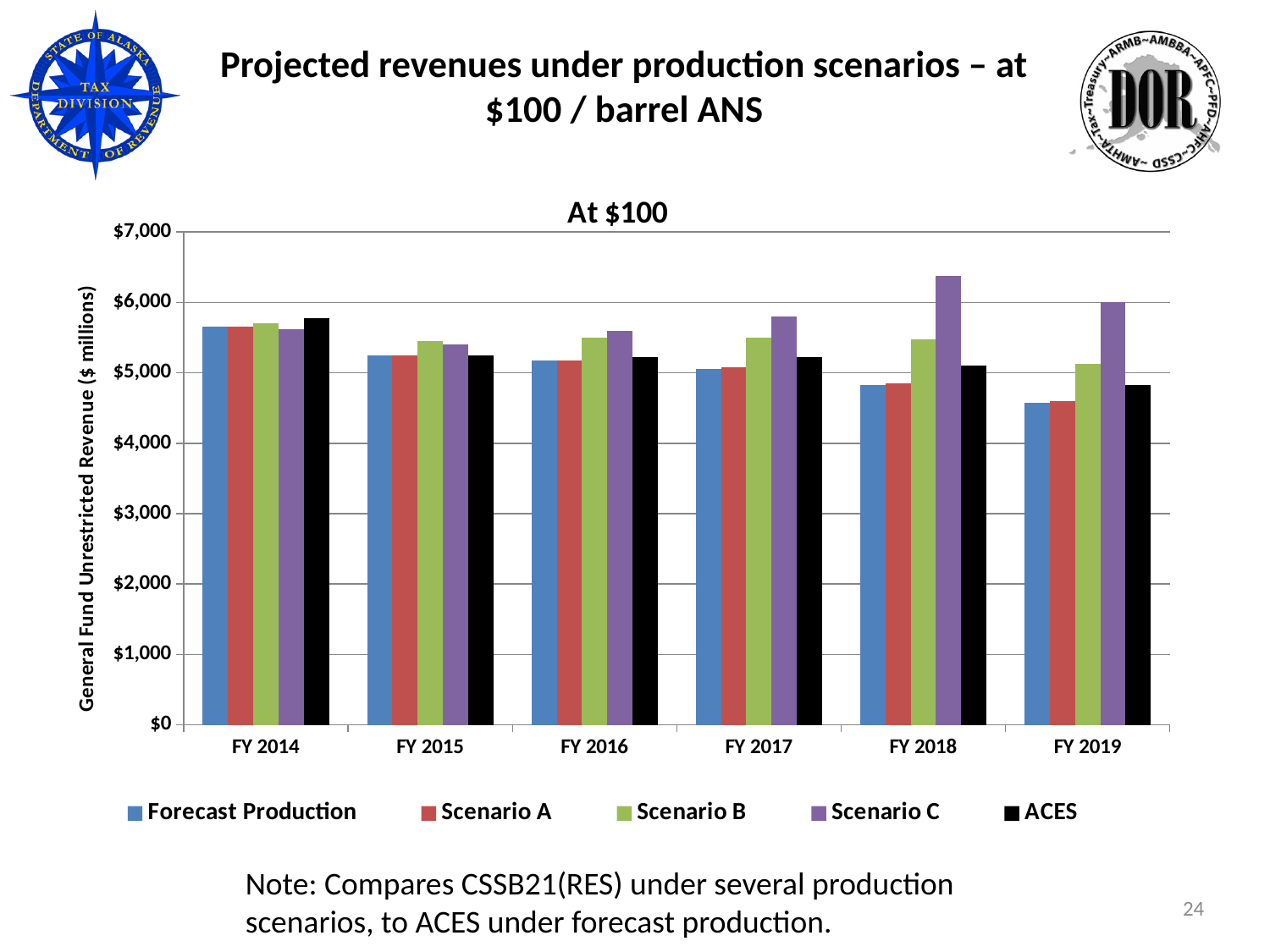
Is the value for Forecast Production in FY 2019 greater or less than $5,000? less How many series does the legend list? 5 In which fiscal year is the Scenario C value highest? FY 2018 In which fiscal year is the Forecast Production value lowest? FY 2019 What kind of chart is shown on the slide? bar chart Do the ACES values rise or fall from FY 2014 to FY 2019? fall Is the value for Scenario C in FY 2018 greater or less than $6,000? greater Is the value for ACES in FY 2014 greater or less than $5,000? greater How many fiscal years are shown on the x axis? 6 In FY 2017, which is larger: Scenario B or ACES? Scenario B Do the Forecast Production values rise or fall from FY 2014 to FY 2019? fall Which series has the highest value in FY 2018? Scenario C